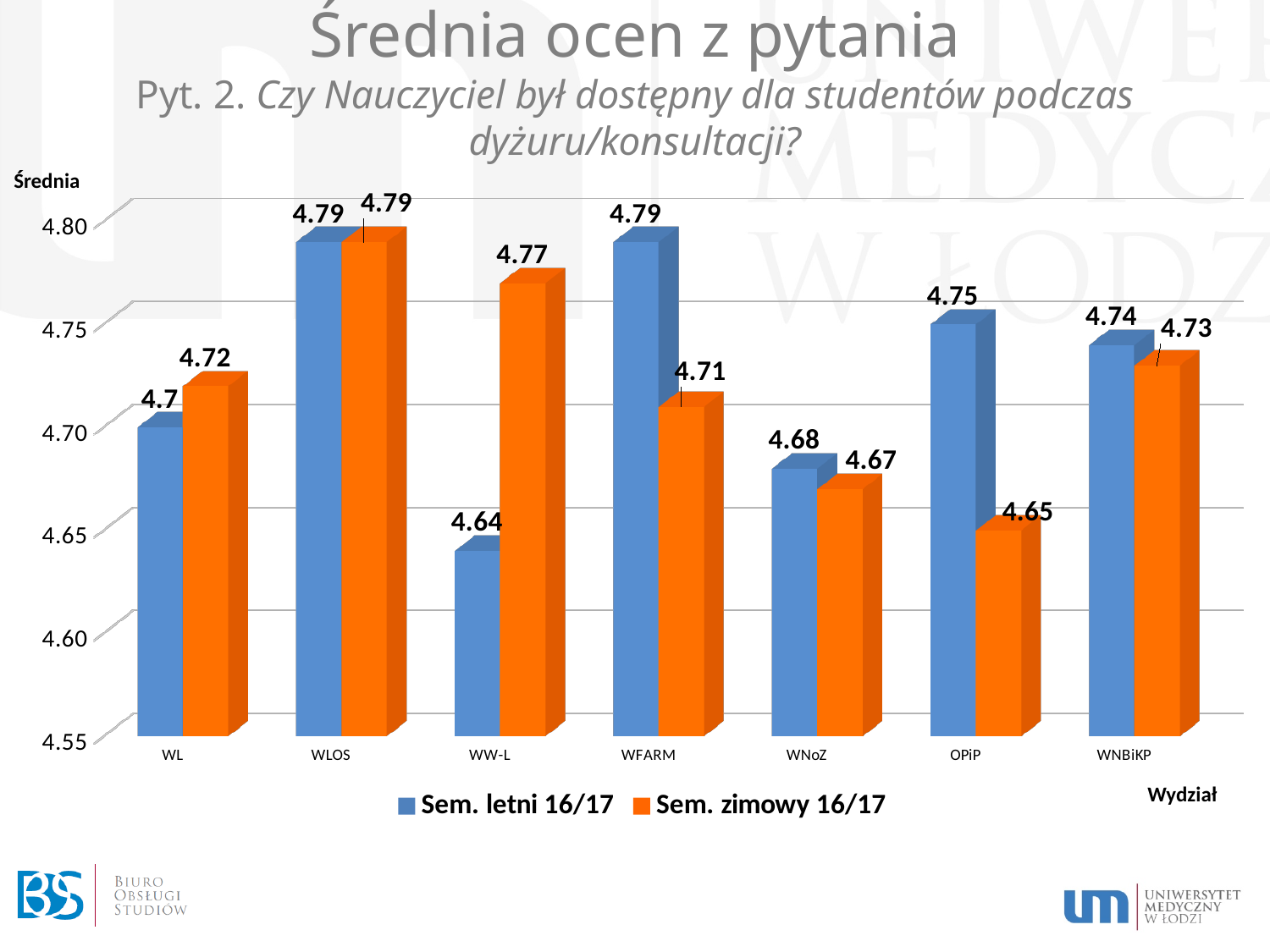
What kind of chart is shown on the slide? Bar chart Which category has the lowest value in the Sem. letni 16/17 series? WW-L What is the value for WW-L in the Sem. zimowy 16/17 series? 4.77 What is the difference between the Sem. zimowy 16/17 and Sem. letni 16/17 values for WW-L? 0.13 What is the value for OPiP in the Sem. letni 16/17 series? 4.75 How many series does the legend list? 2 Which category has the highest value in the Sem. zimowy 16/17 series? WLOS What is the value for WL in the Sem. letni 16/17 series? 4.7 What is the difference between the Sem. letni 16/17 and Sem. zimowy 16/17 values for OPiP? 0.1 How many categories (faculties) are shown on the x axis? 7 For WFARM, which series has the larger value, Sem. letni 16/17 or Sem. zimowy 16/17? Sem. letni 16/17 Which category has the lowest value in the Sem. zimowy 16/17 series? OPiP